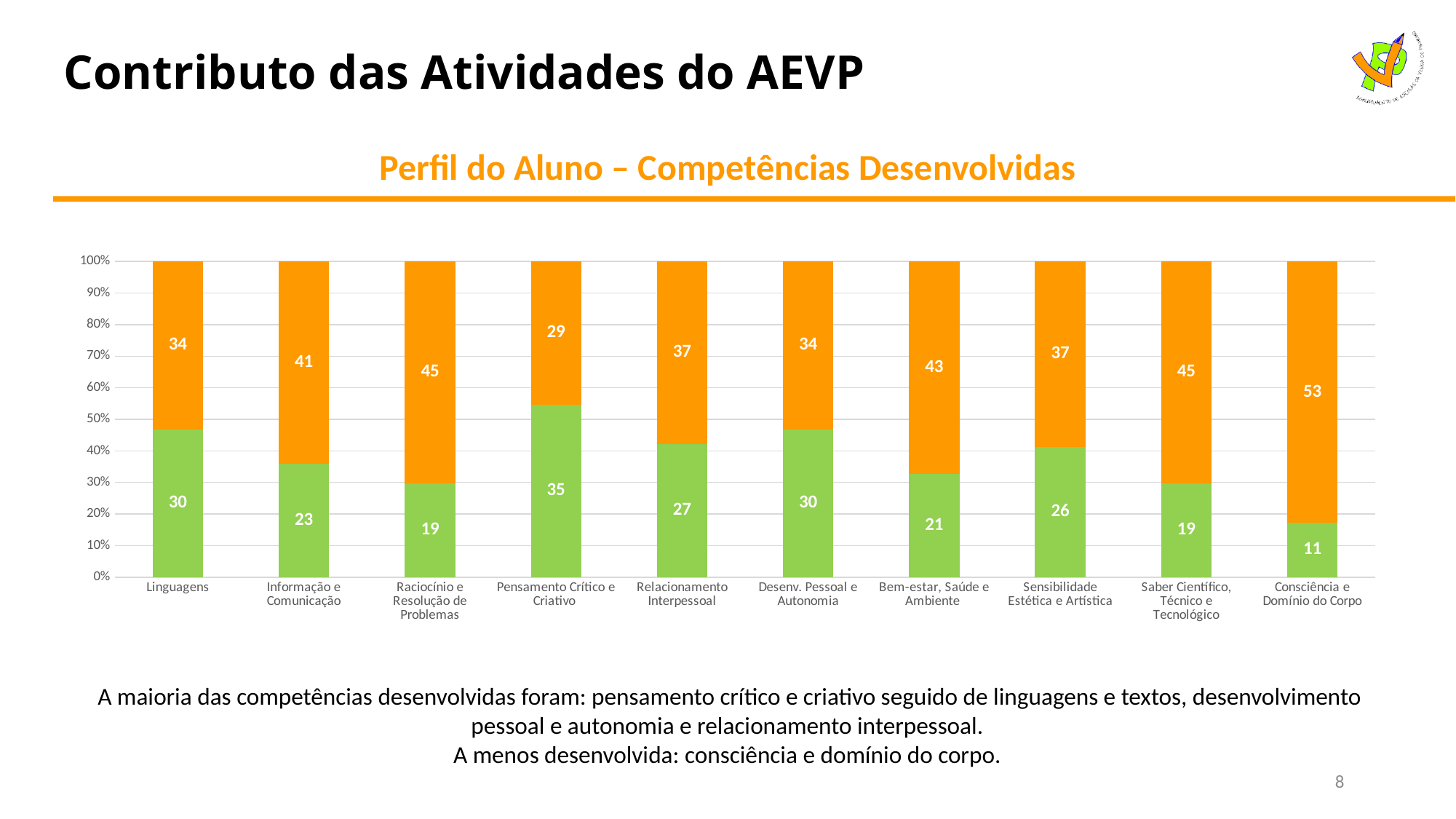
Which category has the highest value printed on its orange segment? Consciência e Domínio do Corpo How many categories are shown on the x axis of the chart? 10 Which category has the highest value printed on its green segment? Pensamento Crítico e Criativo What is the value printed on the green segment of the Linguagens bar? 30 What kind of chart is shown on the slide? stacked bar chart Which is larger for Pensamento Crítico e Criativo: the green value or the orange value? the green value (35) What is the difference between the orange and green values for Raciocínio e Resolução de Problemas? 26 What is the sum of the two values printed on the Linguagens bar? 64 What is the value printed on the orange segment of the Bem-estar, Saúde e Ambiente bar? 43 What is the value printed on the orange segment of the Consciência e Domínio do Corpo bar? 53 Is the top of the green segment for Pensamento Crítico e Criativo greater or less than 50%? greater Which category has the lowest value printed on its green segment? Consciência e Domínio do Corpo